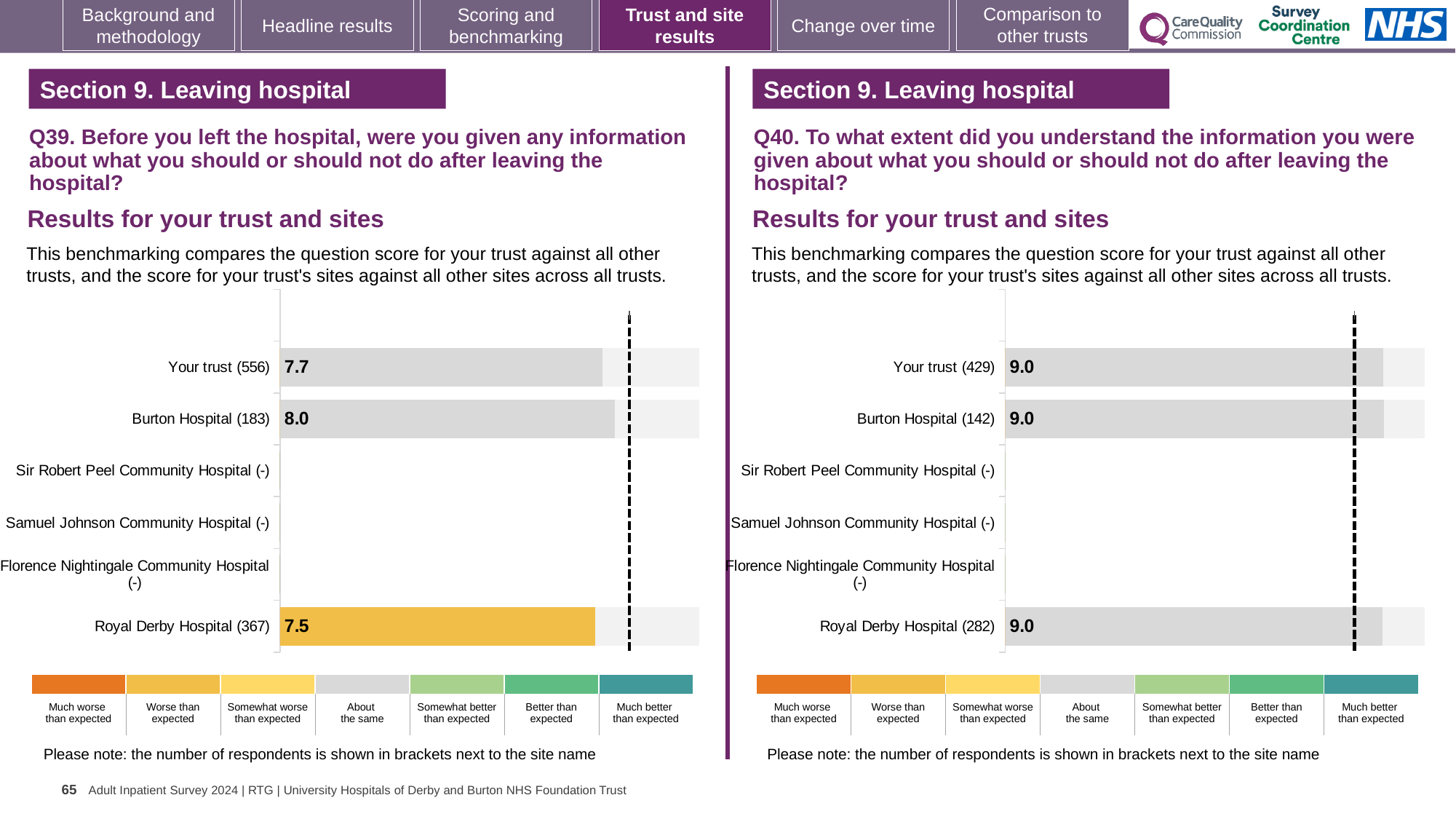
On the Q39 chart (left), what is the score for Your trust? 7.7 On the Q39 chart (left), what is the difference between the Burton Hospital score and the Royal Derby Hospital score? 0.5 On the Q39 chart (left), what is the score for Royal Derby Hospital? 7.5 On the Q40 chart (right), how many respondents are shown for Burton Hospital? 142 On the Q39 chart (left), which site has the lowest score? Royal Derby Hospital On the Q39 chart (left), which site's bar is coloured orange-yellow rather than grey? Royal Derby Hospital What kind of chart is used on the Q39 chart (left)? Bar chart On the Q39 chart (left), which is larger: the score for Your trust or the score for Royal Derby Hospital? Your trust On the Q40 chart (right), what is the score for Royal Derby Hospital? 9.0 On the Q39 chart (left), what is the score for Burton Hospital? 8.0 On the Q40 chart (right), what is the score for Your trust? 9.0 On the Q39 chart (left), which site has the highest score? Burton Hospital